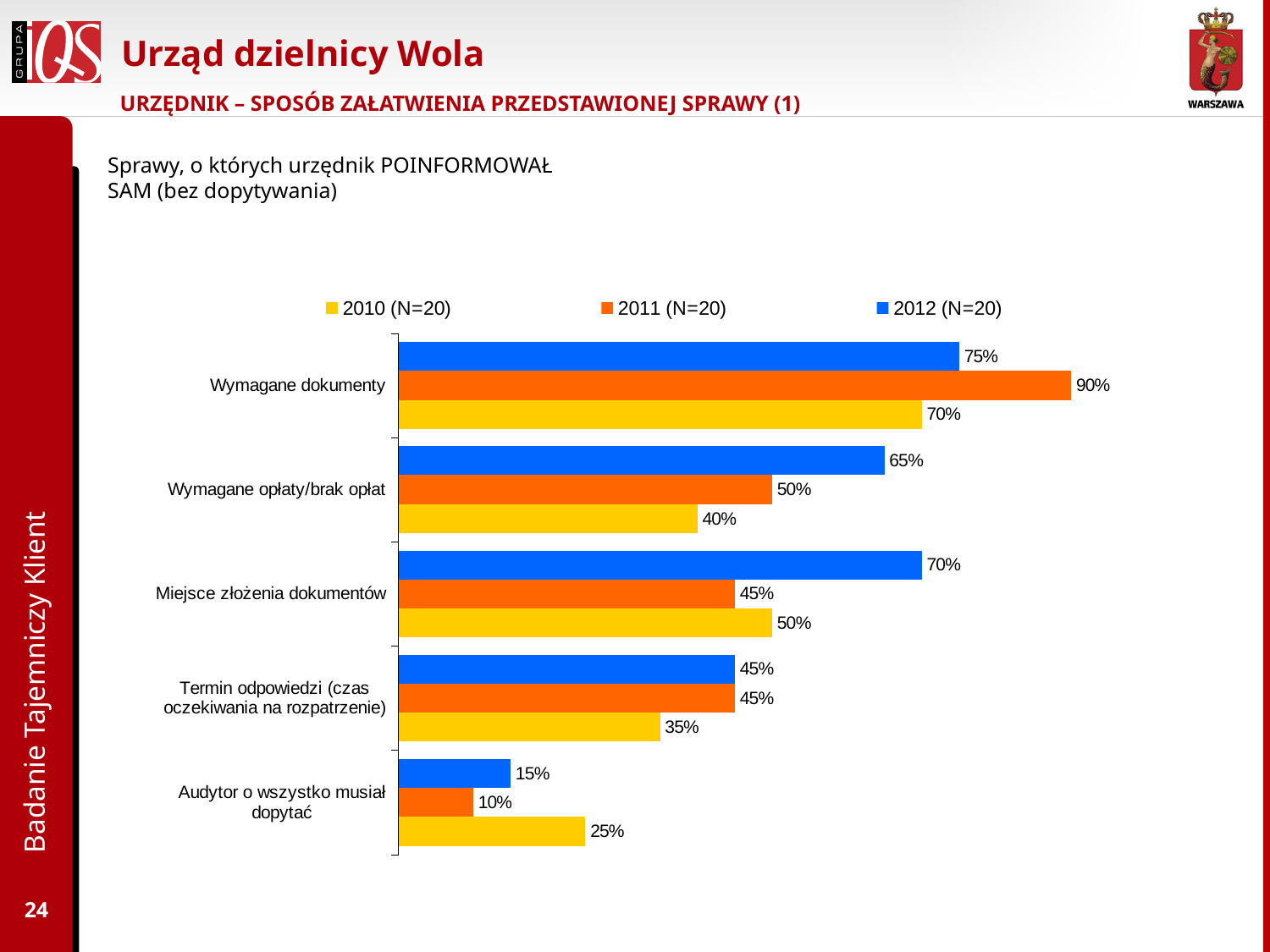
What is the difference between the 2012 (N=20) and 2011 (N=20) values for Miejsce złożenia dokumentów? 25% What kind of chart is shown on the slide? Bar chart Which category has the highest value in the 2012 (N=20) series? Wymagane dokumenty What is the value for Wymagane dokumenty in the 2011 (N=20) series? 90% Which is larger for Audytor o wszystko musiał dopytać: the 2010 (N=20) value or the 2012 (N=20) value? 2010 (N=20) What is the difference between the 2011 (N=20) and 2010 (N=20) values for Wymagane dokumenty? 20% How many series does the legend list? 3 Which colour represents the 2012 (N=20) series in the legend? Blue How many categories are shown on the chart? 5 Which category has the lowest value in the 2011 (N=20) series? Audytor o wszystko musiał dopytać What is the value for Wymagane opłaty/brak opłat in the 2010 (N=20) series? 40% What is the value for Audytor o wszystko musiał dopytać in the 2012 (N=20) series? 15%